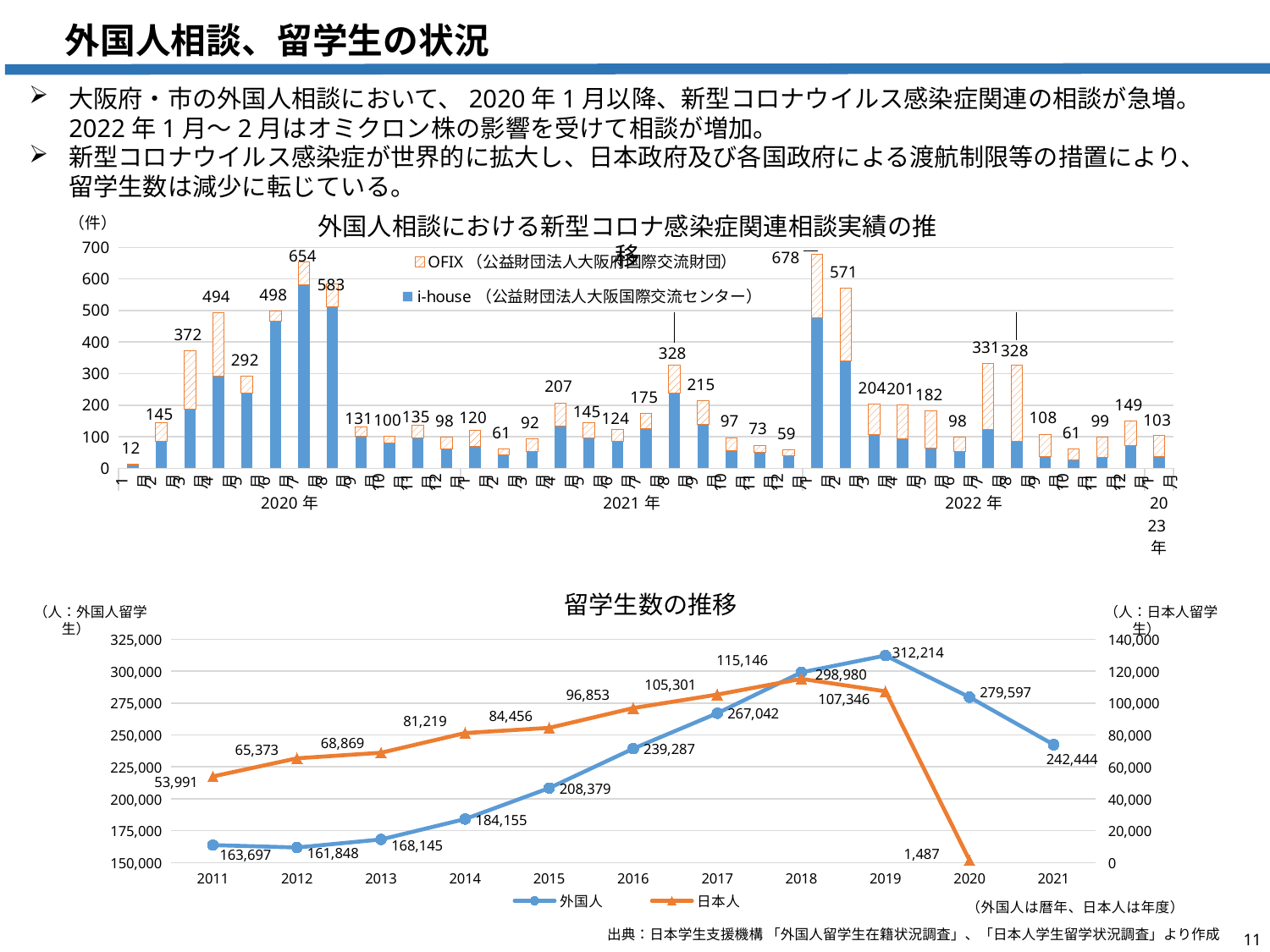
In the top chart (外国人相談における新型コロナ感染症関連相談実績の推移), which month has the lowest labelled total? 2020年1月 (12) In the top chart (外国人相談における新型コロナ感染症関連相談実績の推移), how many series does the legend list? 2 In the bottom chart (留学生数の推移), which is larger for 日本人: the 2018 value or the 2019 value? 2018 (115,146) What kind of chart is the top chart (外国人相談における新型コロナ感染症関連相談実績の推移)? Bar chart (stacked) In the bottom chart (留学生数の推移), in which year is the 外国人 series highest? 2019 In the bottom chart (留学生数の推移), what is the value for 外国人 in 2019? 312,214 In the top chart (外国人相談における新型コロナ感染症関連相談実績の推移), which month has the highest labelled total? 2022年1月 (678) In the bottom chart (留学生数の推移), what is the difference between the 外国人 values for 2019 and 2021? 69,770 In the bottom chart (留学生数の推移), how many years are shown on the x axis? 11 In the top chart (外国人相談における新型コロナ感染症関連相談実績の推移), what is the difference between the totals for 2020年7月 and 2020年8月? 71 In the top chart (外国人相談における新型コロナ感染症関連相談実績の推移), what is the total number of consultations labelled for 2020年7月? 654 In the bottom chart (留学生数の推移), what is the value for 日本人 in 2020? 1,487